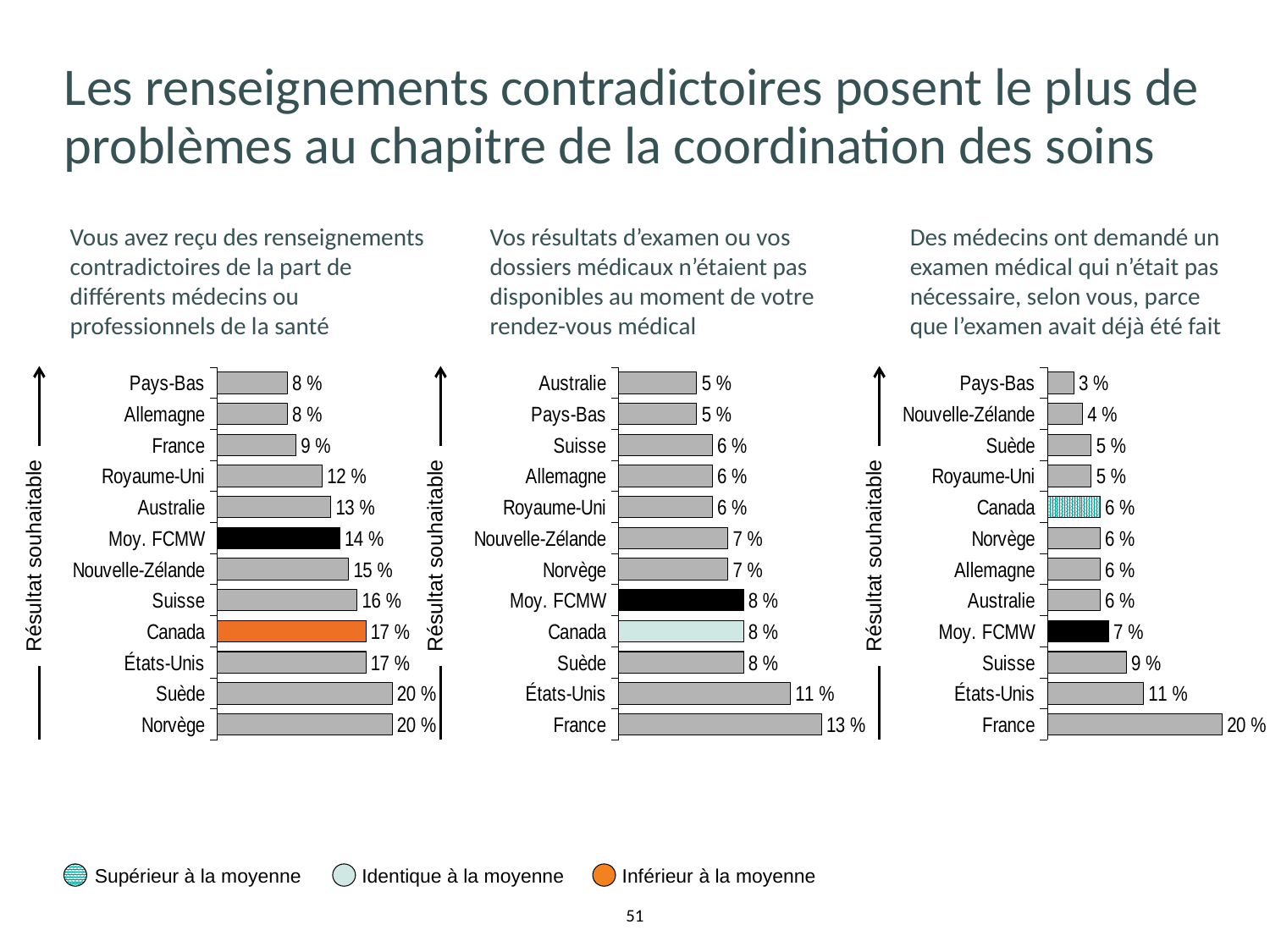
In the middle chart (résultats d'examen non disponibles), which country has the highest value? France In the right chart (examen médical non nécessaire), which country has the lowest value? Pays-Bas In the left chart (renseignements contradictoires), what is the value for Canada? 17 % What type of chart is used on this slide? Bar chart In the left chart (renseignements contradictoires), what is the difference between Canada and Pays-Bas? 9 % In the middle chart (résultats d'examen non disponibles), how many categories are shown? 12 In the middle chart (résultats d'examen non disponibles), what is the value for États-Unis? 11 % In the right chart (examen médical non nécessaire), what is the difference between France and Moy. FCMW? 13 % In the left chart (renseignements contradictoires), what is the value for Moy. FCMW? 14 % In the right chart (examen médical non nécessaire), what is the value for France? 20 % According to the legend, what does the orange colour indicate? Inférieur à la moyenne In the right chart (examen médical non nécessaire), which is larger, the value for Suisse or the value for Canada? Suisse